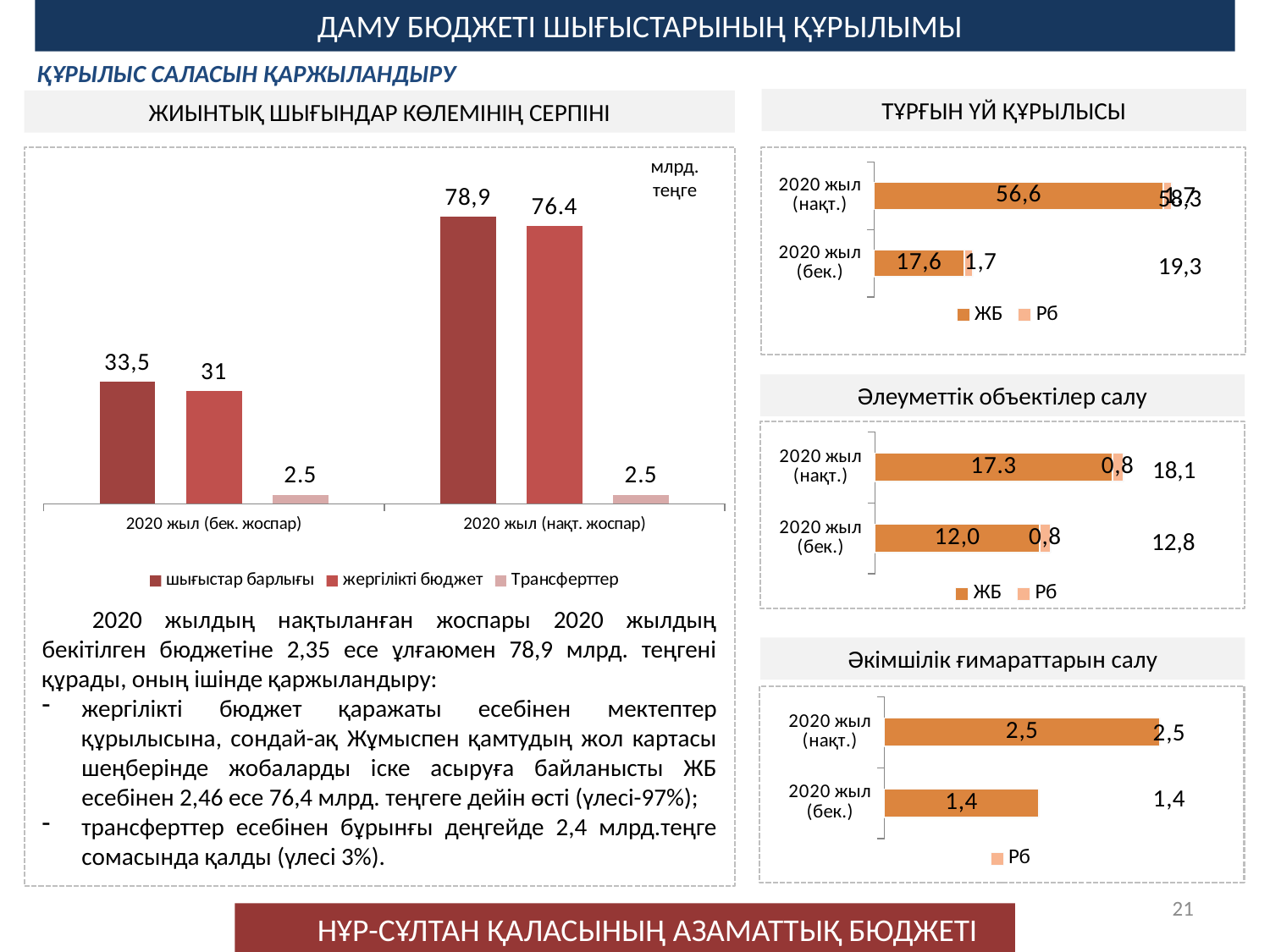
In the chart titled 'ТҰРҒЫН ҮЙ ҚҰРЫЛЫСЫ', what is the value of 'ЖБ' for '2020 жыл (бек.)'? 17,6 In the chart titled 'Әлеуметтік объектілер салу', what is the total of the stacked bar for '2020 жыл (нақт.)'? 18,1 What kind of chart is the one titled 'ЖИЫНТЫҚ ШЫҒЫНДАР КӨЛЕМІНІҢ СЕРПІНІ'? Bar chart In the chart titled 'ЖИЫНТЫҚ ШЫҒЫНДАР КӨЛЕМІНІҢ СЕРПІНІ', what is the value of 'шығыстар барлығы' for '2020 жыл (нақт. жоспар)'? 78,9 In the chart titled 'ЖИЫНТЫҚ ШЫҒЫНДАР КӨЛЕМІНІҢ СЕРПІНІ', which series has the lowest value for '2020 жыл (нақт. жоспар)'? Трансферттер In the chart titled 'ЖИЫНТЫҚ ШЫҒЫНДАР КӨЛЕМІНІҢ СЕРПІНІ', what is the value of 'жергілікті бюджет' for '2020 жыл (бек. жоспар)'? 31 In the chart titled 'ТҰРҒЫН ҮЙ ҚҰРЫЛЫСЫ', what is the total of the stacked bar for '2020 жыл (бек.)'? 19,3 In the chart titled 'ТҰРҒЫН ҮЙ ҚҰРЫЛЫСЫ', which category has the larger 'ЖБ' value, '2020 жыл (нақт.)' or '2020 жыл (бек.)'? 2020 жыл (нақт.) In the chart titled 'Әкімшілік ғимараттарын салу', what is the value for '2020 жыл (бек.)'? 1,4 In the chart titled 'ЖИЫНТЫҚ ШЫҒЫНДАР КӨЛЕМІНІҢ СЕРПІНІ', how many series does the legend list? 3 In the chart titled 'ЖИЫНТЫҚ ШЫҒЫНДАР КӨЛЕМІНІҢ СЕРПІНІ', what is the difference between 'шығыстар барлығы' for '2020 жыл (нақт. жоспар)' and for '2020 жыл (бек. жоспар)'? 45,4 In the chart titled 'Әлеуметтік объектілер салу', what is the value of 'ЖБ' for '2020 жыл (бек.)'? 12,0